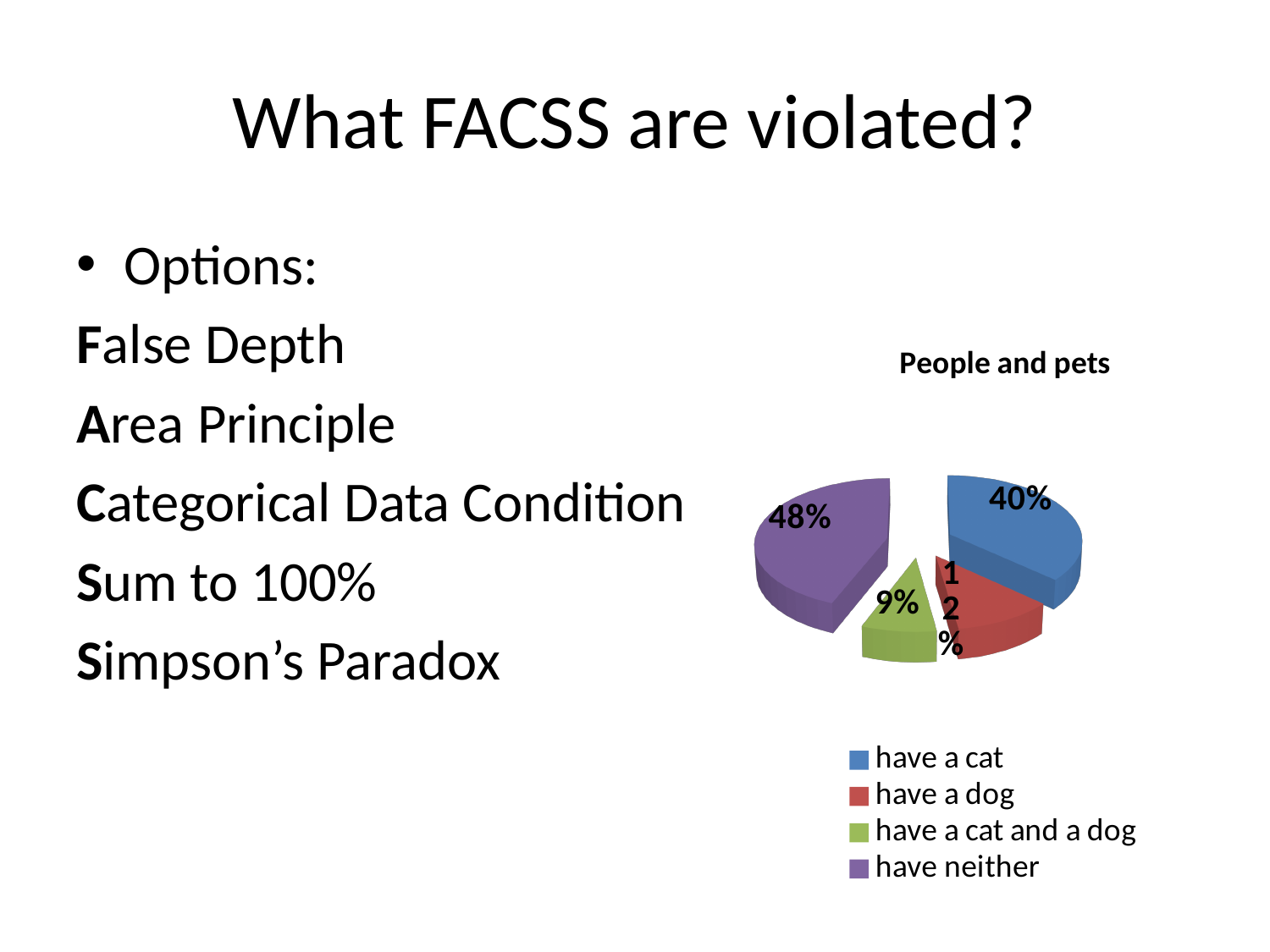
Which category has the largest slice of the pie? have neither What percentage of the pie is labelled for 'have a cat'? 40% Which is larger, the slice for 'have a cat' or the slice for 'have a dog'? have a cat What is the title of the chart? People and pets How many slices does the pie chart have? 4 Which category has the smallest slice of the pie? have a cat and a dog What do the four percentage labels on the pie add up to? 109% What is the difference in percentage points between 'have neither' and 'have a cat'? 8 What percentage is shown for 'have a cat and a dog'? 9% What percentage is shown for 'have neither'? 48% What percentage is shown for 'have a dog'? 12% What type of chart is shown on the slide? pie chart